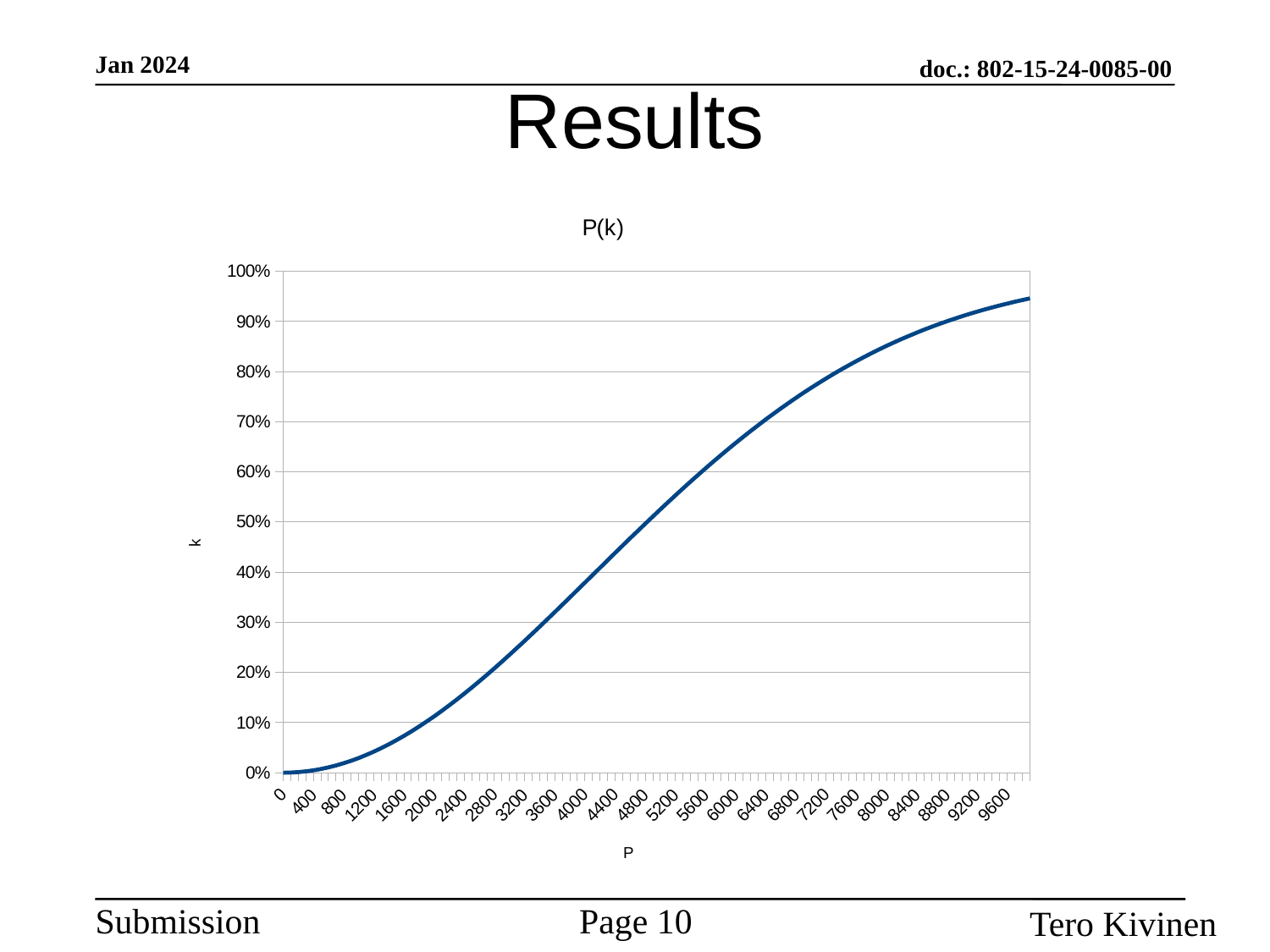
Which is larger, the value of the curve at P = 2400 or at P = 7200? P = 7200 What is the title of the chart? P(k) What is the value of the curve at P = 0? 0% Is the value of the curve at P = 4000 greater or less than 50%? less Is the value of the curve at P = 2000 greater or less than 20%? less Does the curve rise or fall as P increases along the x axis? rises At which end of the x axis does the curve reach its highest value? the right end Is the value of the curve at P = 9600 greater or less than 90%? greater What kind of chart is shown on the slide? line chart What are the labels of the x axis and the y axis of the chart? x axis: P, y axis: k